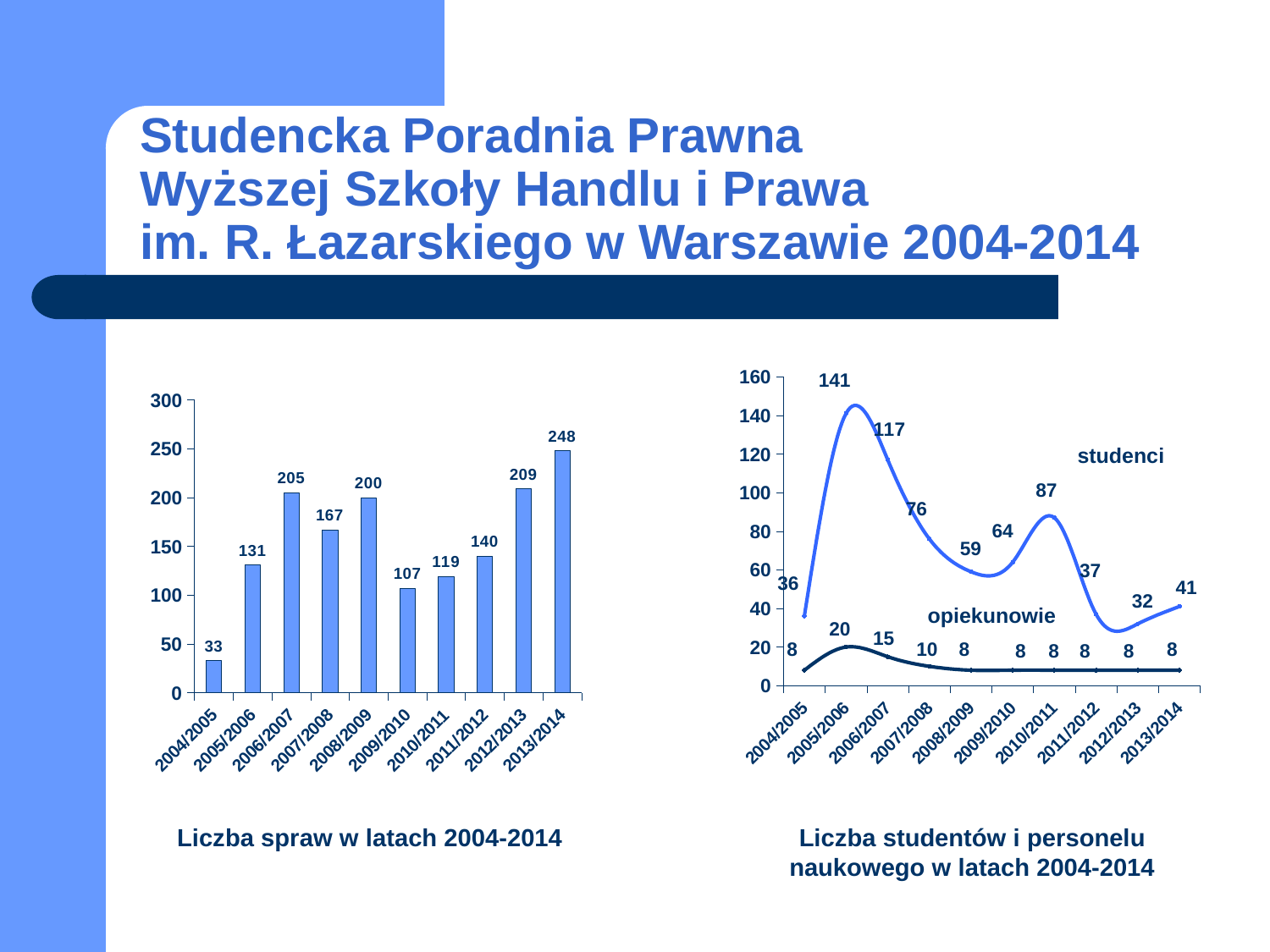
In the left chart (Liczba spraw w latach 2004-2014), what is the difference between the values for 2013/2014 and 2012/2013? 39 In the right chart (Liczba studentów i personelu naukowego w latach 2004-2014), what is the value of the opiekunowie series for 2005/2006? 20 In the left chart (Liczba spraw w latach 2004-2014), which year has the lowest value? 2004/2005 In the right chart (Liczba studentów i personelu naukowego w latach 2004-2014), what is the difference between the studenci and opiekunowie values for 2006/2007? 102 What kind of chart is the right chart (Liczba studentów i personelu naukowego w latach 2004-2014)? line chart What kind of chart is the left chart (Liczba spraw w latach 2004-2014)? bar chart In the right chart (Liczba studentów i personelu naukowego w latach 2004-2014), in which year does the studenci series reach its highest value? 2005/2006 In the left chart (Liczba spraw w latach 2004-2014), how many years are shown on the x axis? 10 In the left chart (Liczba spraw w latach 2004-2014), what is the value for 2006/2007? 205 In the right chart (Liczba studentów i personelu naukowego w latach 2004-2014), what is the value of the studenci series for 2010/2011? 87 In the left chart (Liczba spraw w latach 2004-2014), which year has the highest value? 2013/2014 In the left chart (Liczba spraw w latach 2004-2014), which is larger, the value for 2007/2008 or the value for 2008/2009? 2008/2009